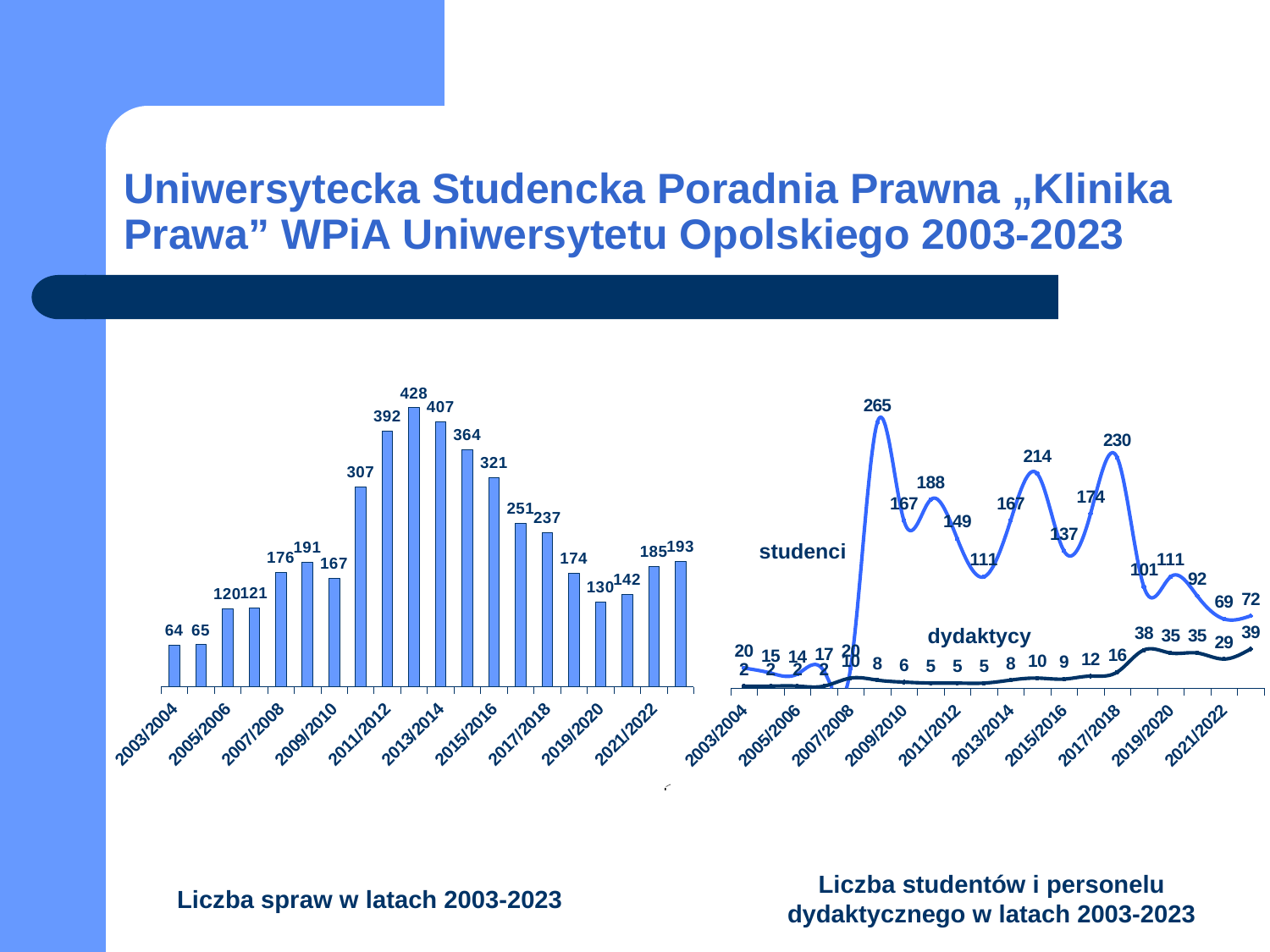
How many series are plotted in the right chart 'Liczba studentów i personelu dydaktycznego w latach 2003-2023'? 2 In the left chart 'Liczba spraw w latach 2003-2023', what is the value for 2003/2004? 64 In the left chart 'Liczba spraw w latach 2003-2023', what is the lowest value shown? 64 How many bars are in the left chart 'Liczba spraw w latach 2003-2023'? 20 In the left chart 'Liczba spraw w latach 2003-2023', what is the highest value shown? 428 In the left chart 'Liczba spraw w latach 2003-2023', what is the value for 2011/2012? 392 In the left chart 'Liczba spraw w latach 2003-2023', what is the difference between the values for 2013/2014 and 2011/2012? 15 What kind of chart is the right chart, 'Liczba studentów i personelu dydaktycznego w latach 2003-2023'? Line chart What kind of chart is the left chart, 'Liczba spraw w latach 2003-2023'? Bar chart In the left chart 'Liczba spraw w latach 2003-2023', which is larger, the value for 2015/2016 or for 2017/2018? 2015/2016 In the left chart 'Liczba spraw w latach 2003-2023', what is the value for 2019/2020? 130 In the right chart 'Liczba studentów i personelu dydaktycznego w latach 2003-2023', what is the highest value of the 'studenci' series? 265